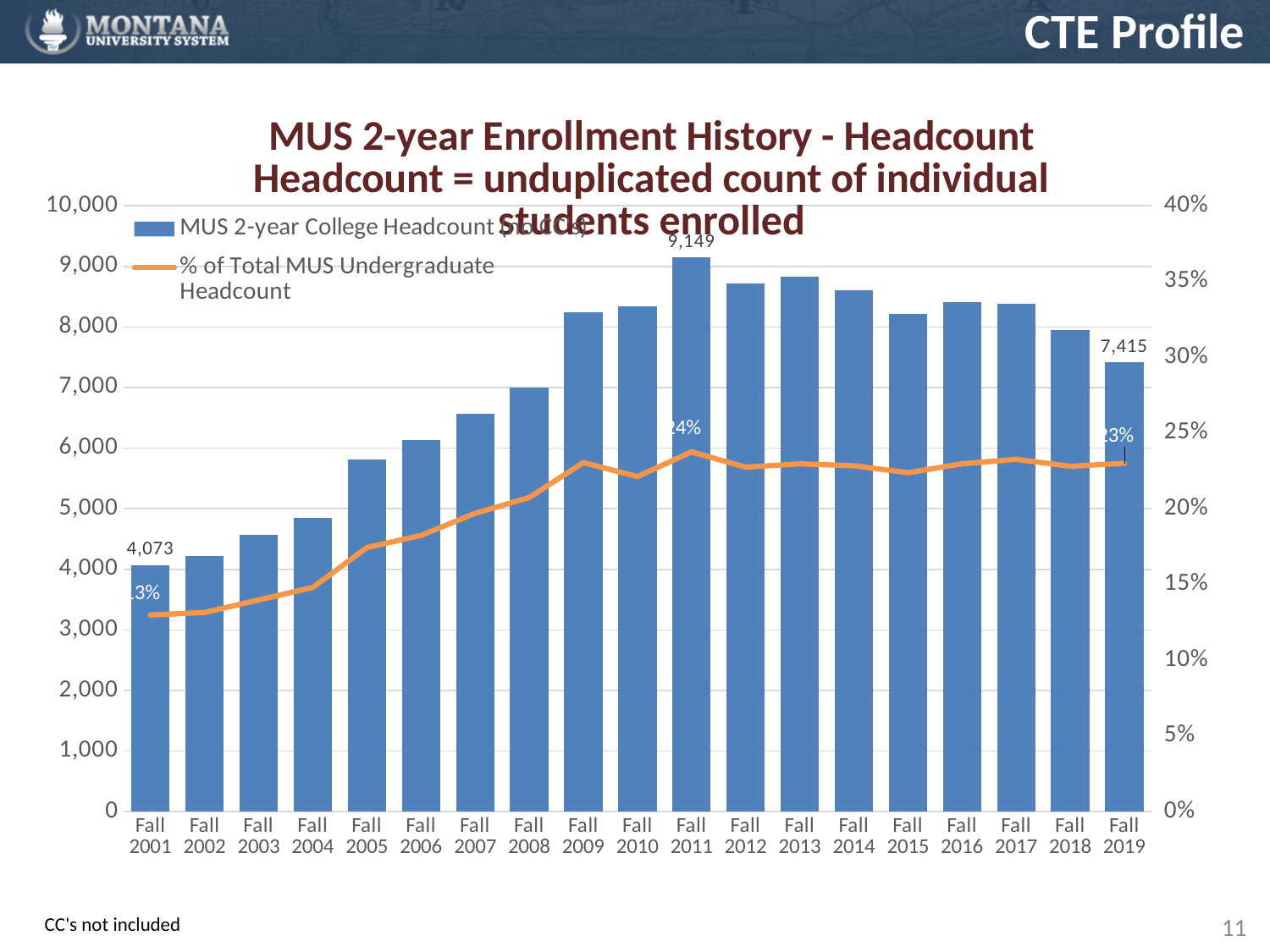
Which has the larger headcount, Fall 2005 or Fall 2009? Fall 2009 By how much did the headcount decline from Fall 2011 to Fall 2019? 1,734 What is the MUS 2-year College Headcount for Fall 2001? 4,073 How much higher is the headcount in Fall 2011 than in Fall 2001? 5,076 Which fall term has the lowest MUS 2-year College Headcount? Fall 2001 Which fall term has the highest MUS 2-year College Headcount? Fall 2011 How many series does the legend list? 2 Is the headcount for Fall 2013 greater or less than 8,000? greater What is the MUS 2-year College Headcount for Fall 2011? 9,149 How many fall terms are shown on the x axis? 19 What is the % of Total MUS Undergraduate Headcount shown for Fall 2011? 24% What is the MUS 2-year College Headcount for Fall 2019? 7,415